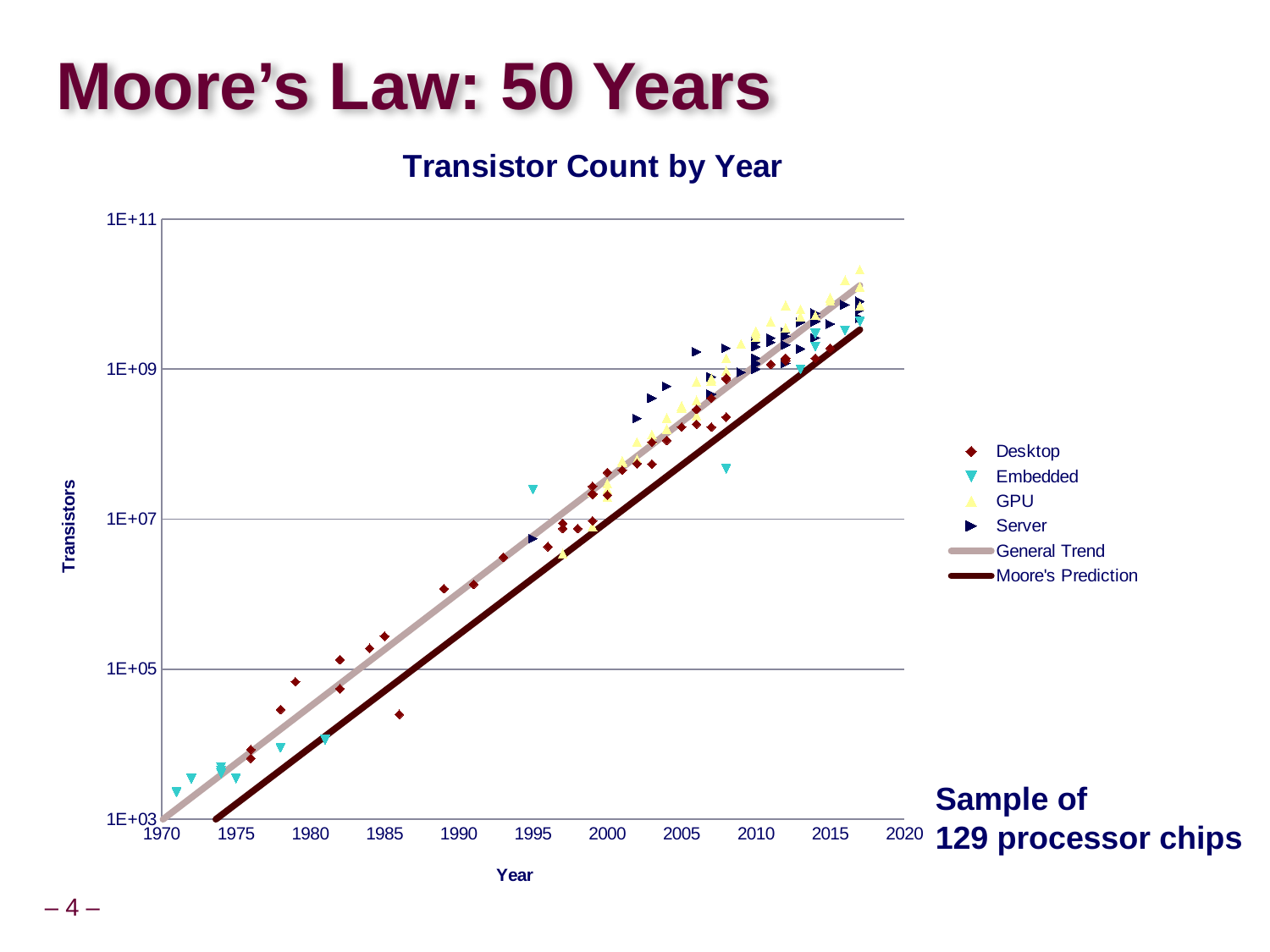
Is the Desktop point plotted around 1986 greater or less than 1E+05 transistors? less How many entries does the chart legend list? 6 Do transistor counts rise or fall as the year increases along the x axis? rise How many processor chips are in the sample according to the slide? 129 Which line lies higher on the chart, General Trend or Moore's Prediction? General Trend Are the Embedded points plotted in the early 1970s greater or less than 1E+05 transistors? less What is the title of the chart? Transistor Count by Year What label is shown on the y axis of the chart? Transistors What kind of chart is shown on the slide? scatter chart Which series contains the highest plotted point on the chart? GPU Is the Embedded point plotted around 2008 greater or less than 1E+09 transistors? less